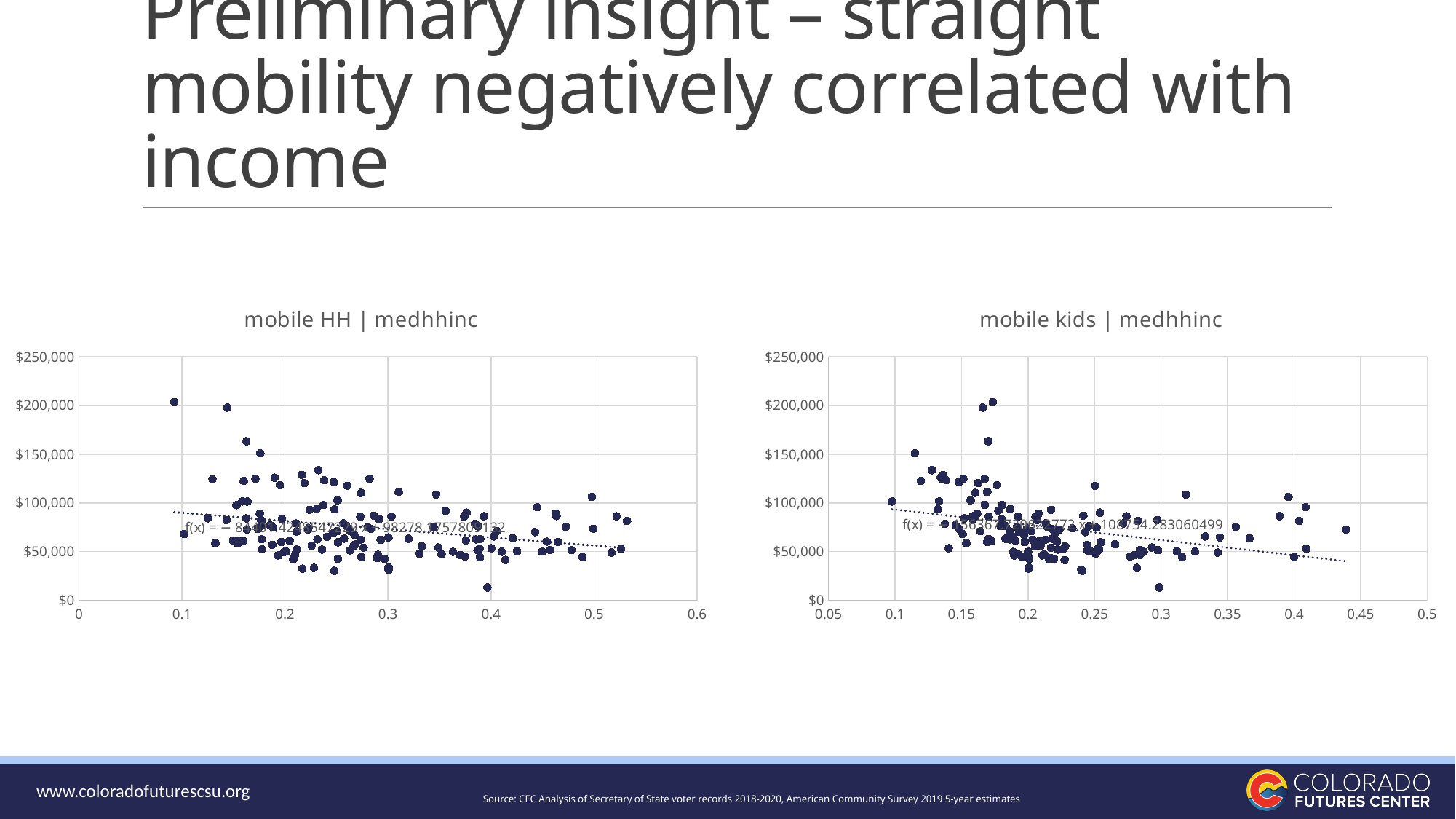
What kind of chart is the right chart titled "mobile kids | medhhinc"? scatter chart What kind of chart is the left chart titled "mobile HH | medhhinc"? scatter chart What are the titles of the two charts on the slide? mobile HH | medhhinc and mobile kids | medhhinc In the left chart (mobile HH | medhhinc), is the highest plotted point greater or less than $150,000? greater In the left chart (mobile HH | medhhinc), is the lowest plotted point greater or less than $50,000? less In the right chart (mobile kids | medhhinc), do the values generally rise or fall as the x-axis value increases? fall In the left chart (mobile HH | medhhinc), do the values generally rise or fall as the x-axis value increases? fall In the right chart (mobile kids | medhhinc), is the highest plotted point greater or less than $150,000? greater In the left chart (mobile HH | medhhinc), does the dotted trendline slope upward or downward? downward How many charts are shown on the slide? 2 What is the maximum value shown on the y-axis of the left chart (mobile HH | medhhinc)? $250,000